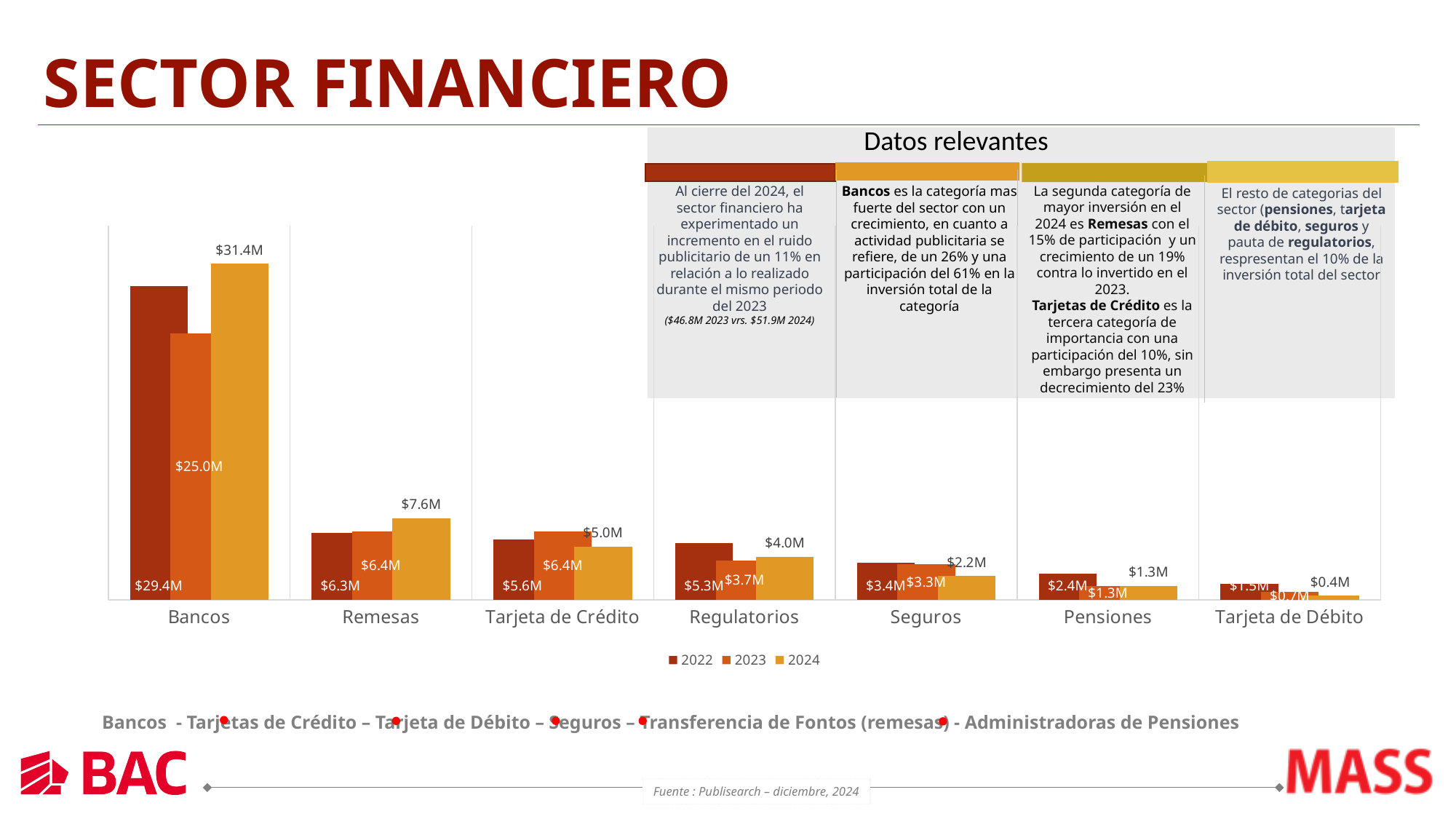
What is the 2024 value for Remesas? $7.6M How many series does the legend list? 3 What is the difference between the 2024 and 2023 values for Bancos? $6.4M Which category has the highest 2024 value? Bancos Which category has the lowest 2024 value? Tarjeta de Débito What is the 2024 value for Seguros? $2.2M What is the 2022 value for Regulatorios? $5.3M What is the 2023 value for Bancos? $25.0M How many categories are shown on the x axis? 7 What kind of chart is shown on the slide? Bar chart Which is larger for Tarjeta de Crédito, the 2023 value or the 2024 value? 2023 What is the 2024 value for Bancos? $31.4M